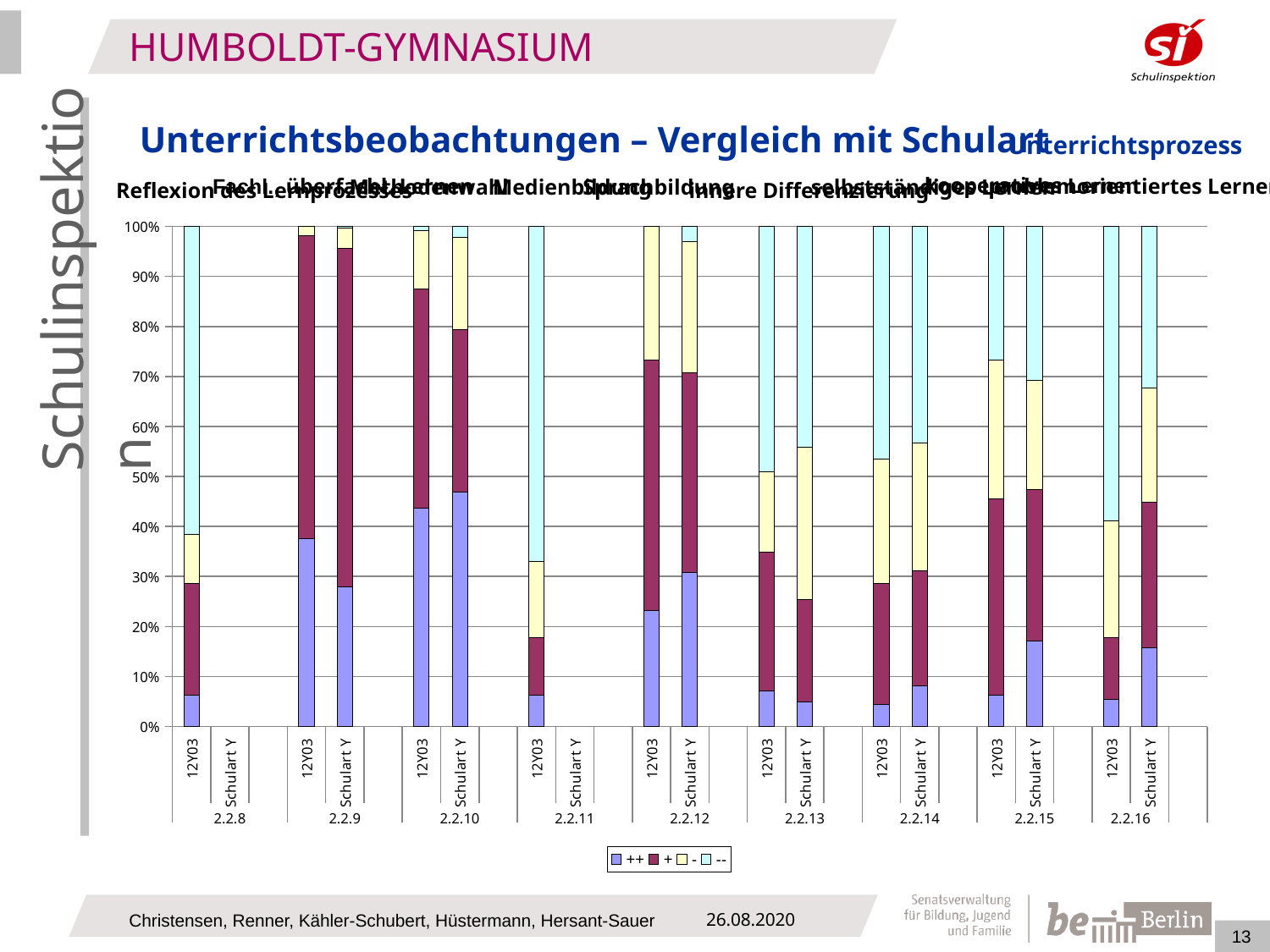
Is the '++' share for Schulart Y in category 2.2.10 greater or less than 40%? greater What kind of chart is shown on the slide? Stacked bar chart Is the '++' share for 12Y03 in category 2.2.8 greater or less than 10%? less How many category groups (2.2.8 to 2.2.16) are shown on the x axis? 9 What is the title of the slide containing the chart? Unterrichtsbeobachtungen – Vergleich mit Schulart How many series does the chart legend list? 4 In category 2.2.9, which bar has the larger '++' share, 12Y03 or Schulart Y? 12Y03 Is the '++' share for 12Y03 in category 2.2.12 greater or less than 30%? less In category 2.2.15, which bar has the larger '++' share, 12Y03 or Schulart Y? Schulart Y What are the entries in the chart legend? ++, +, -, --